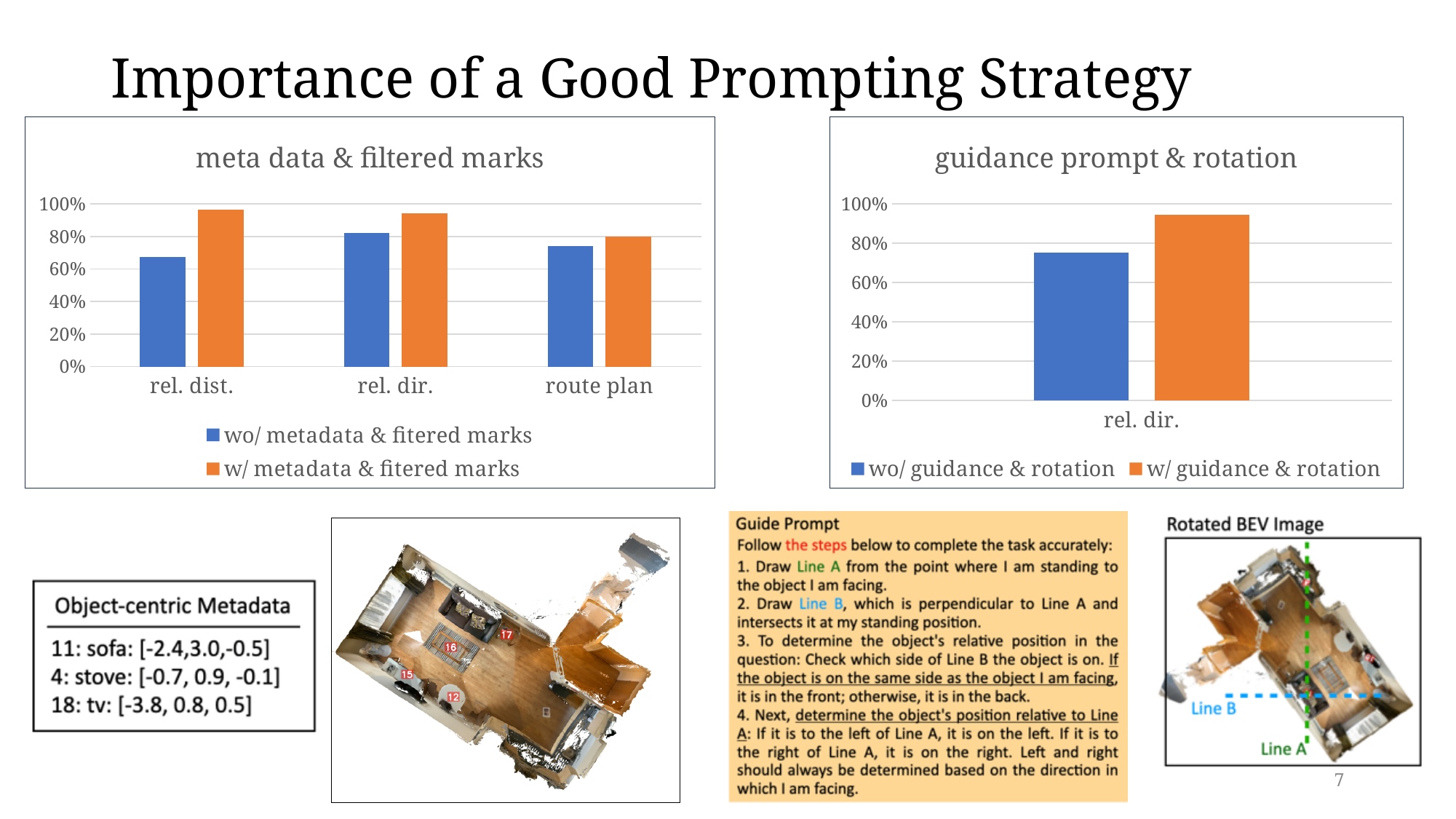
What type of chart is the 'meta data & filtered marks' chart? bar chart In the 'meta data & filtered marks' chart, which category has the highest value for 'wo/ metadata & fitered marks'? rel. dir. In the 'meta data & filtered marks' chart, for route plan, which series has the larger value? w/ metadata & fitered marks In the 'meta data & filtered marks' chart, which category has the lowest value for 'w/ metadata & fitered marks'? route plan In the 'meta data & filtered marks' chart, is the value for 'w/ metadata & fitered marks' at rel. dist. greater or less than 80%? greater In the 'meta data & filtered marks' chart, is the value for 'wo/ metadata & fitered marks' at rel. dist. greater or less than 80%? less In the 'guidance prompt & rotation' chart, is the value for 'wo/ guidance & rotation' greater or less than 80%? less How many categories are shown on the x axis of the 'meta data & filtered marks' chart? 3 In the 'meta data & filtered marks' chart, which category has the lowest value for 'wo/ metadata & fitered marks'? rel. dist. How many series does the legend of the 'guidance prompt & rotation' chart list? 2 What is the only category shown on the x axis of the 'guidance prompt & rotation' chart? rel. dir.